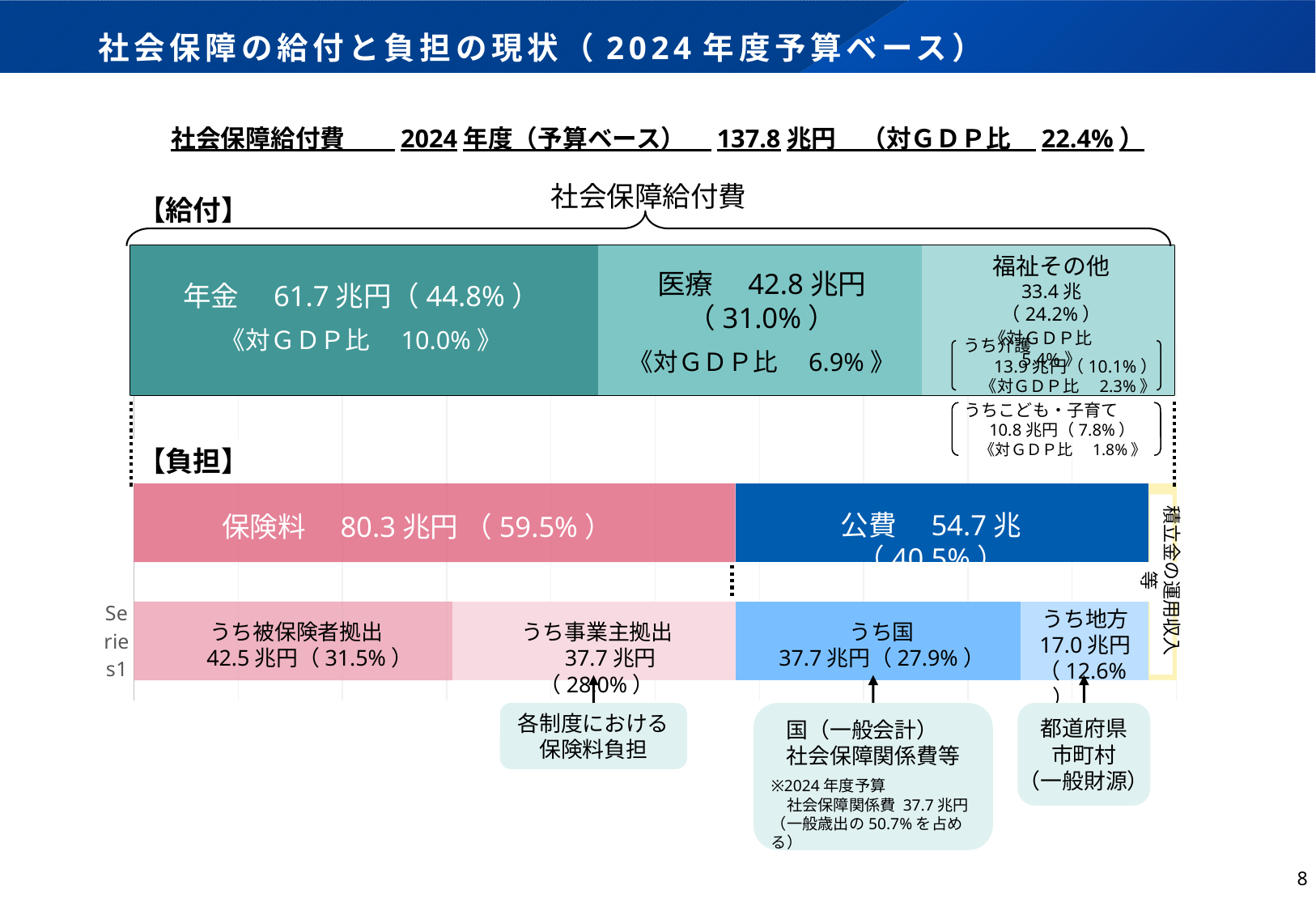
What is the value shown for 保険料 in the 【負担】 bar? 80.3兆円 Which is larger in the 【負担】 bar, 保険料 or 公費? 保険料 How many segments make up the lower 【負担】 breakdown bar (うち被保険者拠出, うち事業主拠出, うち国, うち地方)? 4 What is the value shown for うち地方 in the lower 【負担】 breakdown bar? 17.0兆円 Which segment of the 【給付】 bar is the largest? 年金 Which segment of the 【給付】 bar is the smallest? 福祉その他 What percentage share is shown for 医療 in the 【給付】 bar? 31.0% What is the value shown for 年金 in the 【給付】 bar? 61.7兆円 What percentage share is shown for 公費 in the 【負担】 bar? 40.5% What kind of chart is used on this slide? Stacked bar chart What is the difference between 年金 (61.7兆円) and 医療 (42.8兆円) in the 【給付】 bar? 18.9兆円